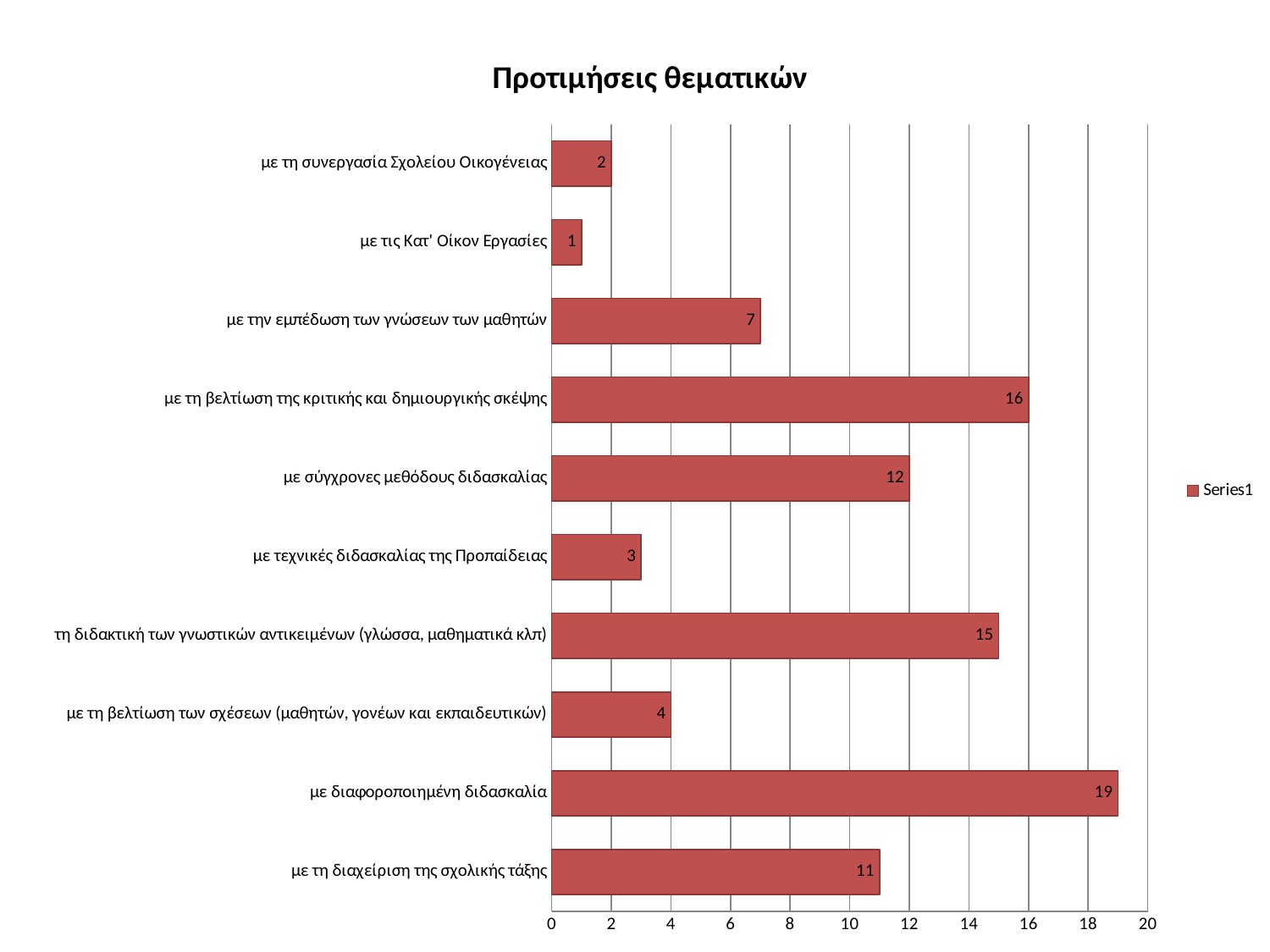
What is the value for 'με τις Κατ' Οίκον Εργασίες'? 1 What is the value for 'με διαφοροποιημένη διδασκαλία'? 19 Is the value for 'με τη βελτίωση των σχέσεων (μαθητών, γονέων και εκπαιδευτικών)' greater or less than 10? less Which category has the lowest value? με τις Κατ' Οίκον Εργασίες How many series does the legend list? 1 How many categories are shown in the chart? 10 What is the title of the chart? Προτιμήσεις θεματικών What is the value for 'με σύγχρονες μεθόδους διδασκαλίας'? 12 Which is larger: the value for 'τη διδακτική των γνωστικών αντικειμένων (γλώσσα, μαθηματικά κλπ)' or the value for 'με τη διαχείριση της σχολικής τάξης'? τη διδακτική των γνωστικών αντικειμένων (γλώσσα, μαθηματικά κλπ) Which category has the highest value? με διαφοροποιημένη διδασκαλία What is the difference between the values for 'με τη βελτίωση της κριτικής και δημιουργικής σκέψης' and 'με την εμπέδωση των γνώσεων των μαθητών'? 9 What kind of chart is shown on the slide? bar chart